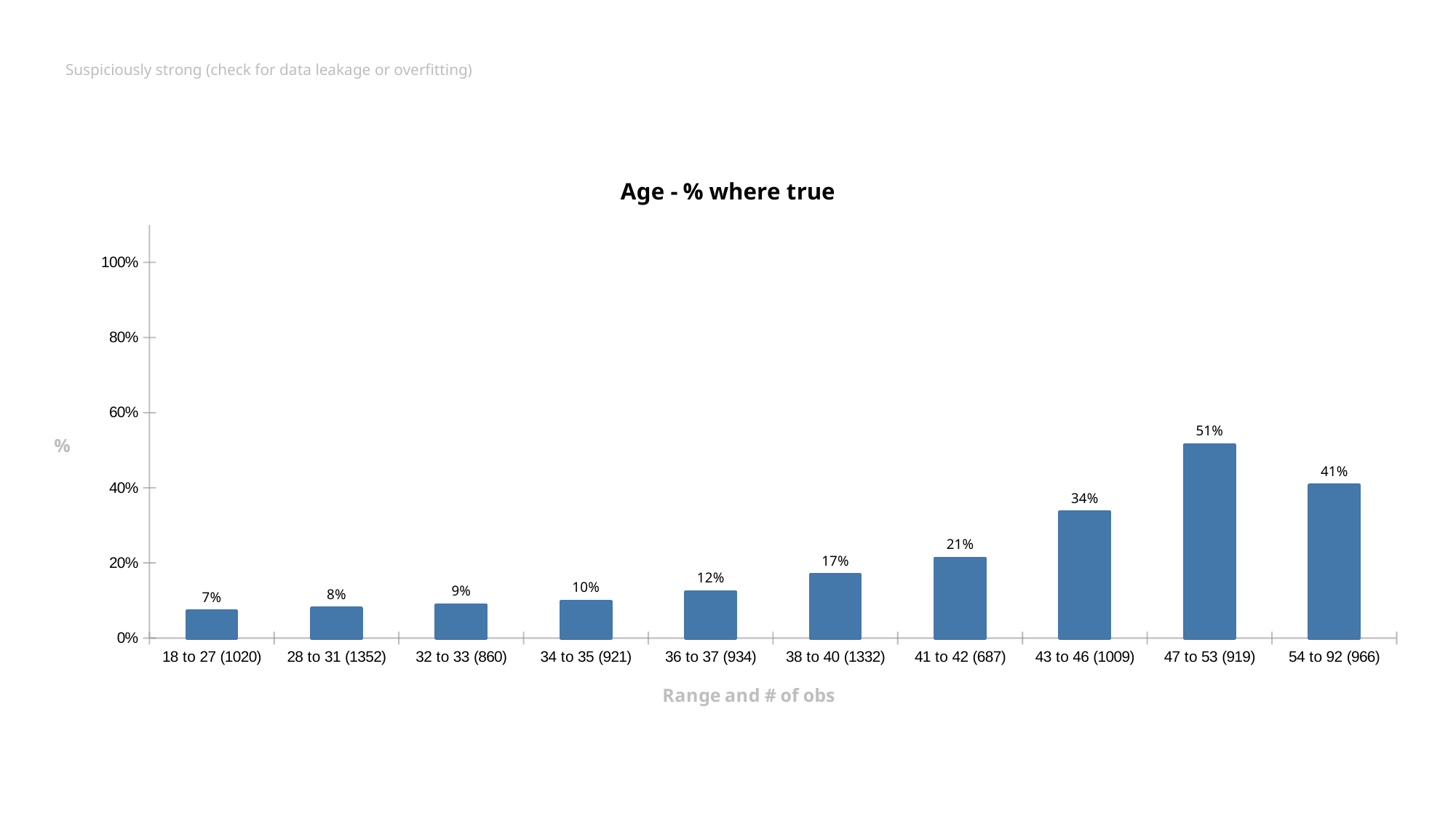
Which age range has the lowest value? 18 to 27 (1020) What kind of chart is shown on the slide? bar chart What is the title of the chart? Age - % where true How many age ranges are shown on the x axis? 10 Which is larger, the value for 41 to 42 (687) or the value for 36 to 37 (934)? 41 to 42 (687) What is the difference between the values for 47 to 53 (919) and 54 to 92 (966)? 10% Which age range has the highest value? 47 to 53 (919) What is the value for the 38 to 40 (1332) age range? 17% Do the values generally rise or fall from the youngest to the oldest age range? rise Is the value for 54 to 92 (966) greater or less than 60%? less What is the value for the 43 to 46 (1009) age range? 34% What is the value for the 18 to 27 (1020) age range? 7%